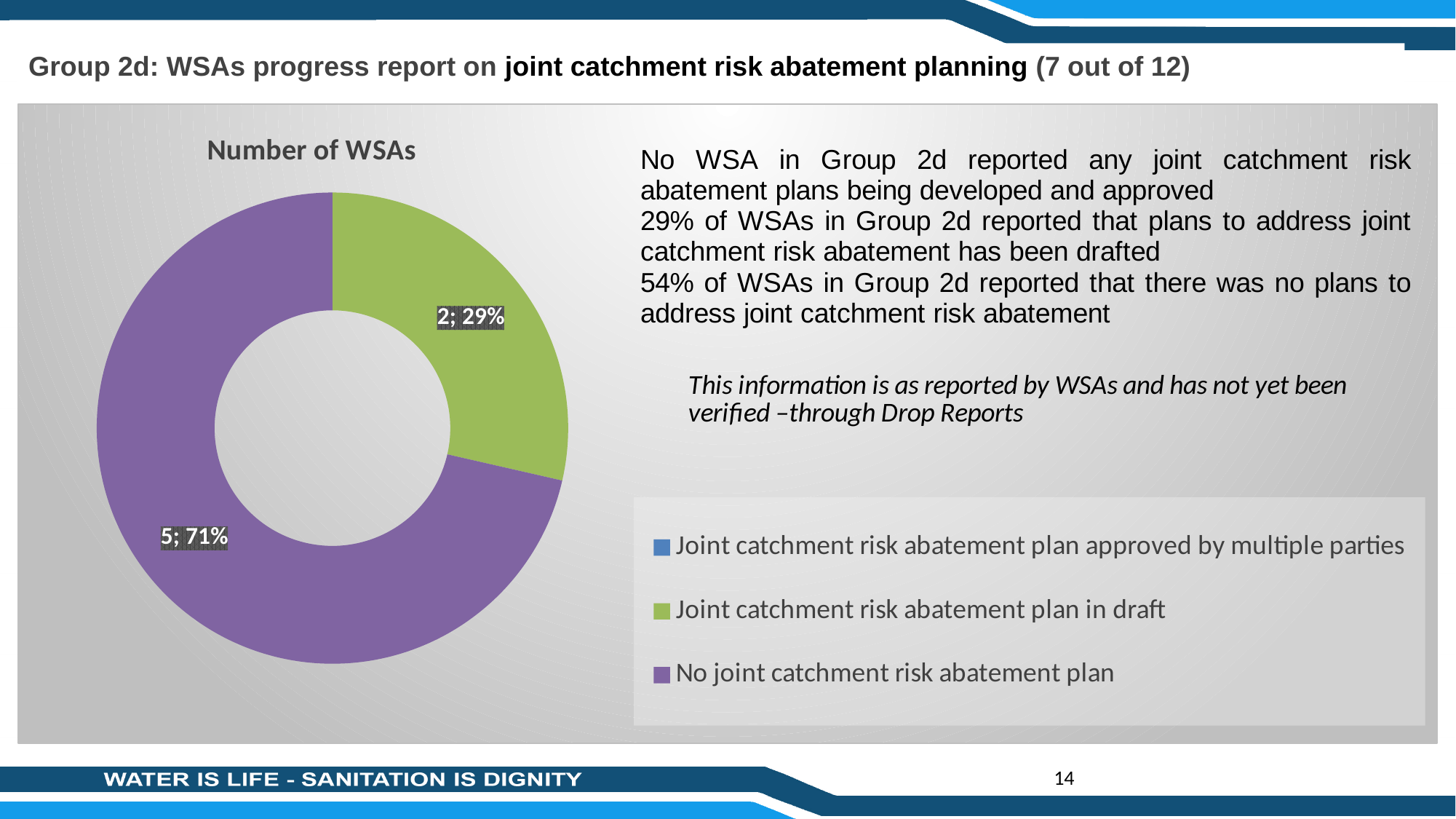
How many entries does the chart legend list? 3 How many WSAs reported a joint catchment risk abatement plan in draft? 2 What kind of chart is shown on the slide? Doughnut (pie) chart What share of the chart is taken by 'No joint catchment risk abatement plan'? 71% What is the title of the chart? Number of WSAs Which category has the largest slice in the chart? No joint catchment risk abatement plan Which of the visible slices is the smallest? Joint catchment risk abatement plan in draft How many WSAs reported no joint catchment risk abatement plan? 5 What colour represents 'Joint catchment risk abatement plan in draft' in the chart? Green What is the difference in the number of WSAs between 'No joint catchment risk abatement plan' and 'Joint catchment risk abatement plan in draft'? 3 What share of the chart is taken by 'Joint catchment risk abatement plan in draft'? 29% Which is larger: the slice for 'Joint catchment risk abatement plan in draft' or the slice for 'No joint catchment risk abatement plan'? No joint catchment risk abatement plan